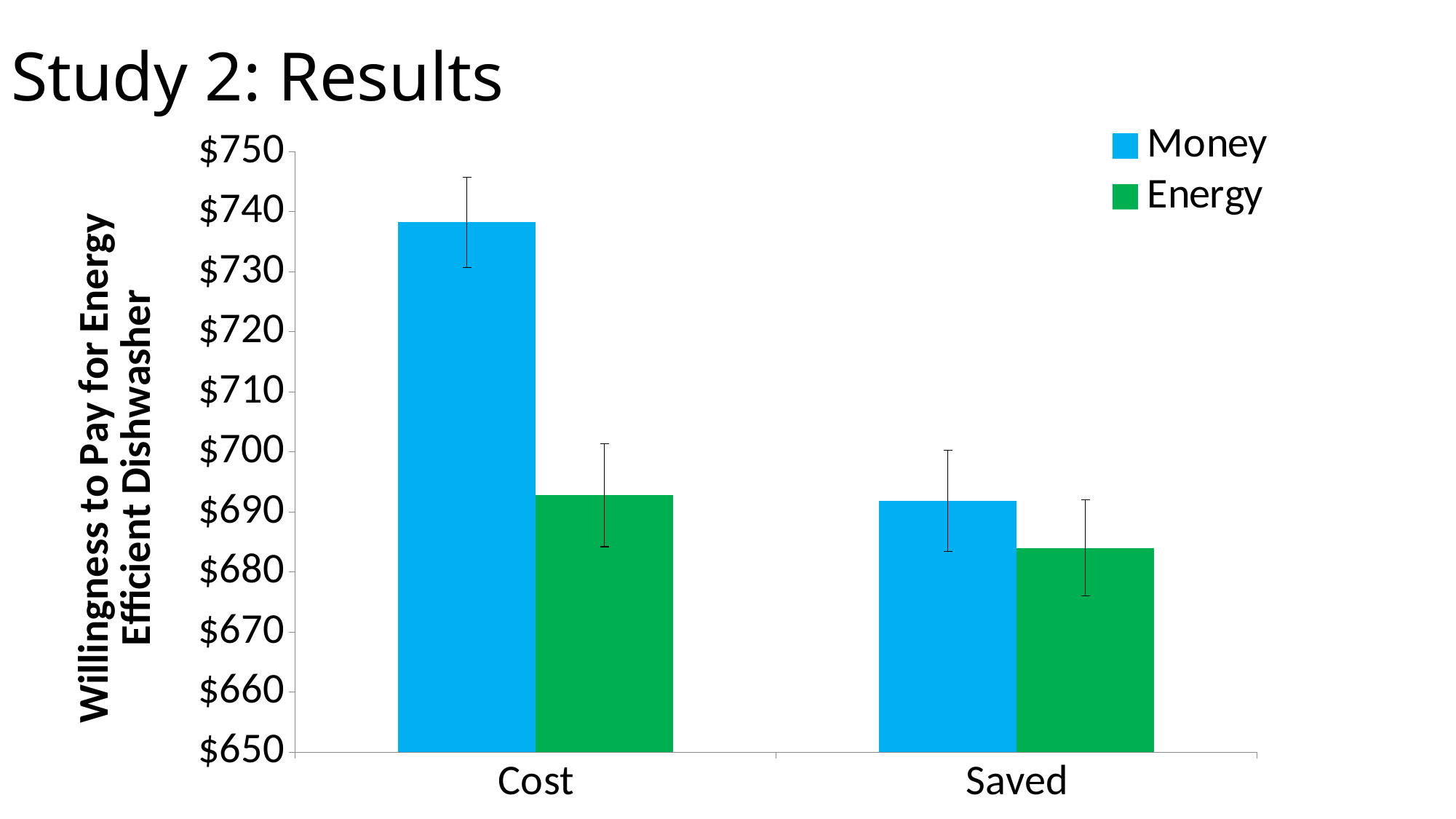
Is the value for Energy in the Cost category greater or less than $700? less Which colour represents the Energy series in the legend? green How many categories are shown on the x axis? 2 How many series does the legend list? 2 In the Cost category, which series has the larger value, Money or Energy? Money Which series has the lowest bar in the Saved category? Energy Is the value for Money in the Saved category greater or less than $700? less What kind of chart is shown on the slide? bar chart Is the value for Money in the Cost category greater or less than $730? greater Which series and category combination has the highest bar? Money, Cost What is the title of the y axis? Willingness to Pay for Energy Efficient Dishwasher